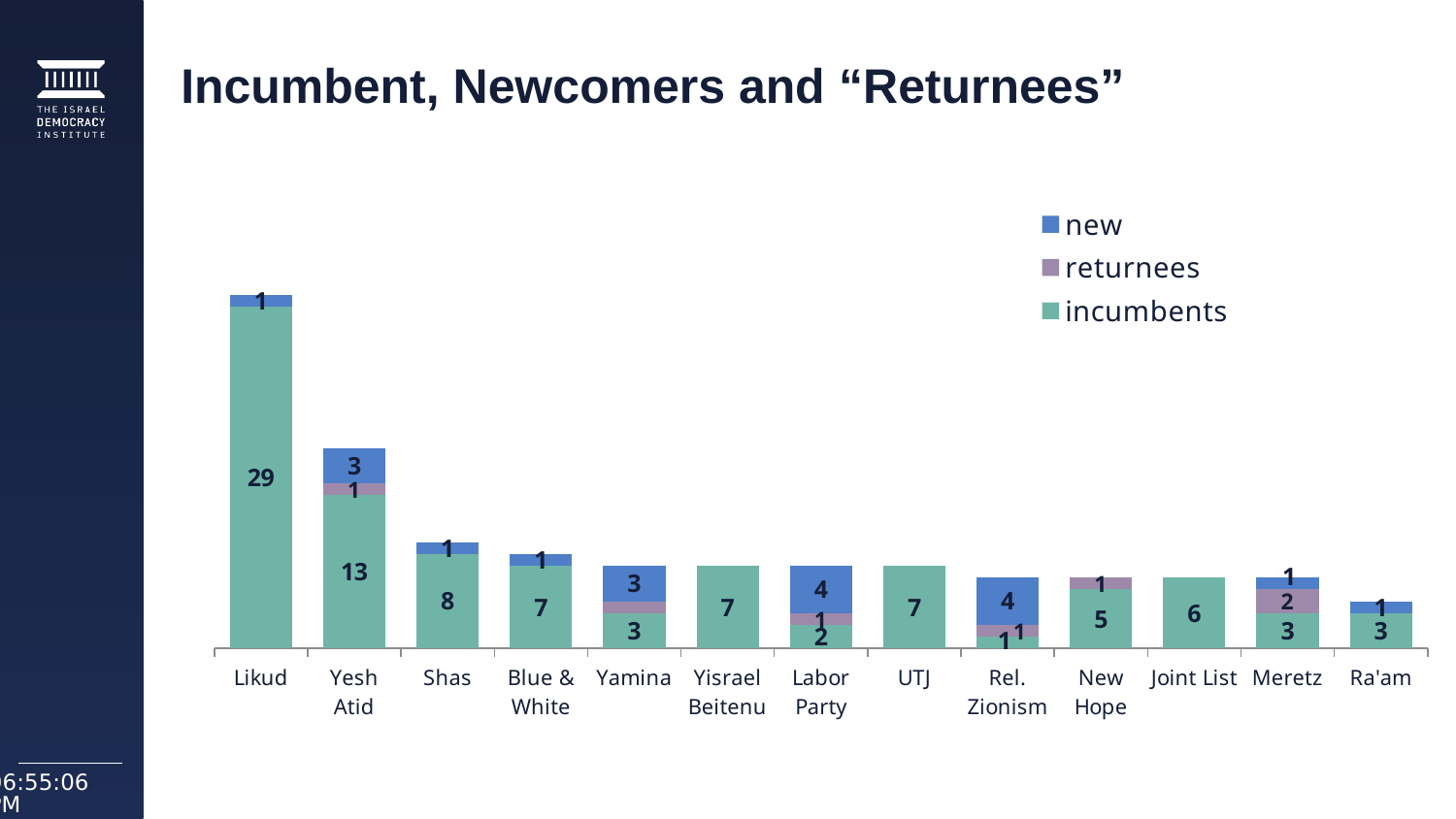
What kind of chart is shown on the slide? Stacked bar chart How many incumbents does Likud have according to the chart? 29 What is the difference between the number of incumbents for Likud and for Yesh Atid? 16 What is the total of the Yesh Atid bar (incumbents, returnees and new combined)? 17 What are the three entries listed in the chart legend? new, returnees, incumbents Which has more new members, Yamina or Rel. Zionism? Rel. Zionism How many series does the legend list? 3 How many returnees are shown for Meretz? 2 Which party has the highest number of incumbents? Likud How many incumbents are shown for New Hope? 5 What is the value for new members in the Labor Party bar? 4 How many parties are shown on the x axis of the chart? 13